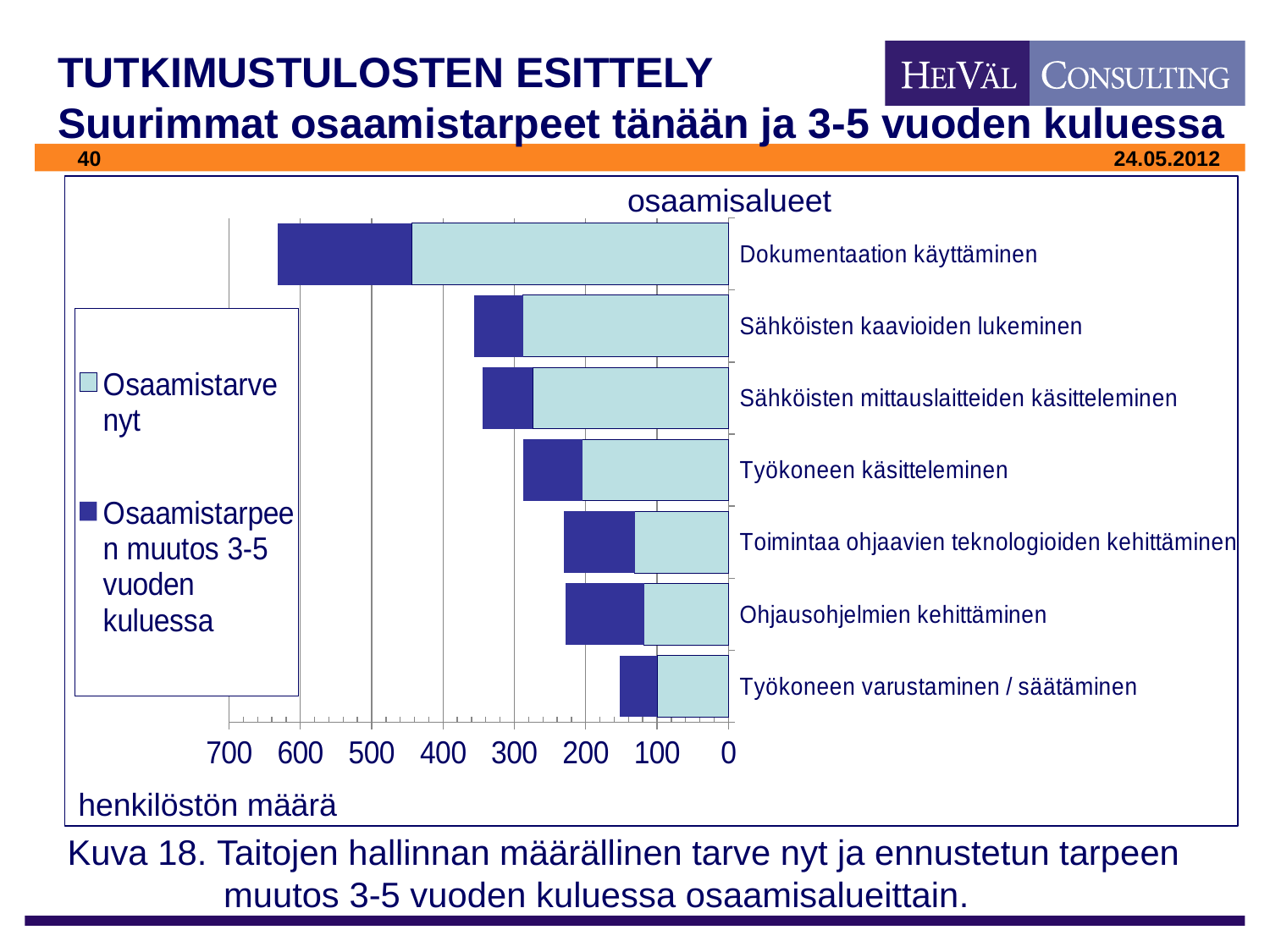
Which competence area has the shortest total bar? Työkoneen varustaminen / säätäminen What kind of chart is shown on the slide? stacked bar chart Which has the larger total bar: Dokumentaation käyttäminen or Työkoneen käsitteleminen? Dokumentaation käyttäminen What is the title shown above the category labels of the chart? osaamisalueet How many series does the chart legend list? 2 Is the total bar for Työkoneen varustaminen / säätäminen greater or less than 200? less How many competence areas (categories) are plotted in the chart? 7 Is the total bar for Dokumentaation käyttäminen greater or less than 600? greater Which competence area has the longest total bar? Dokumentaation käyttäminen Is the total bar for Sähköisten kaavioiden lukeminen greater or less than 300? greater What is the label of the horizontal axis of the chart? henkilöstön määrä